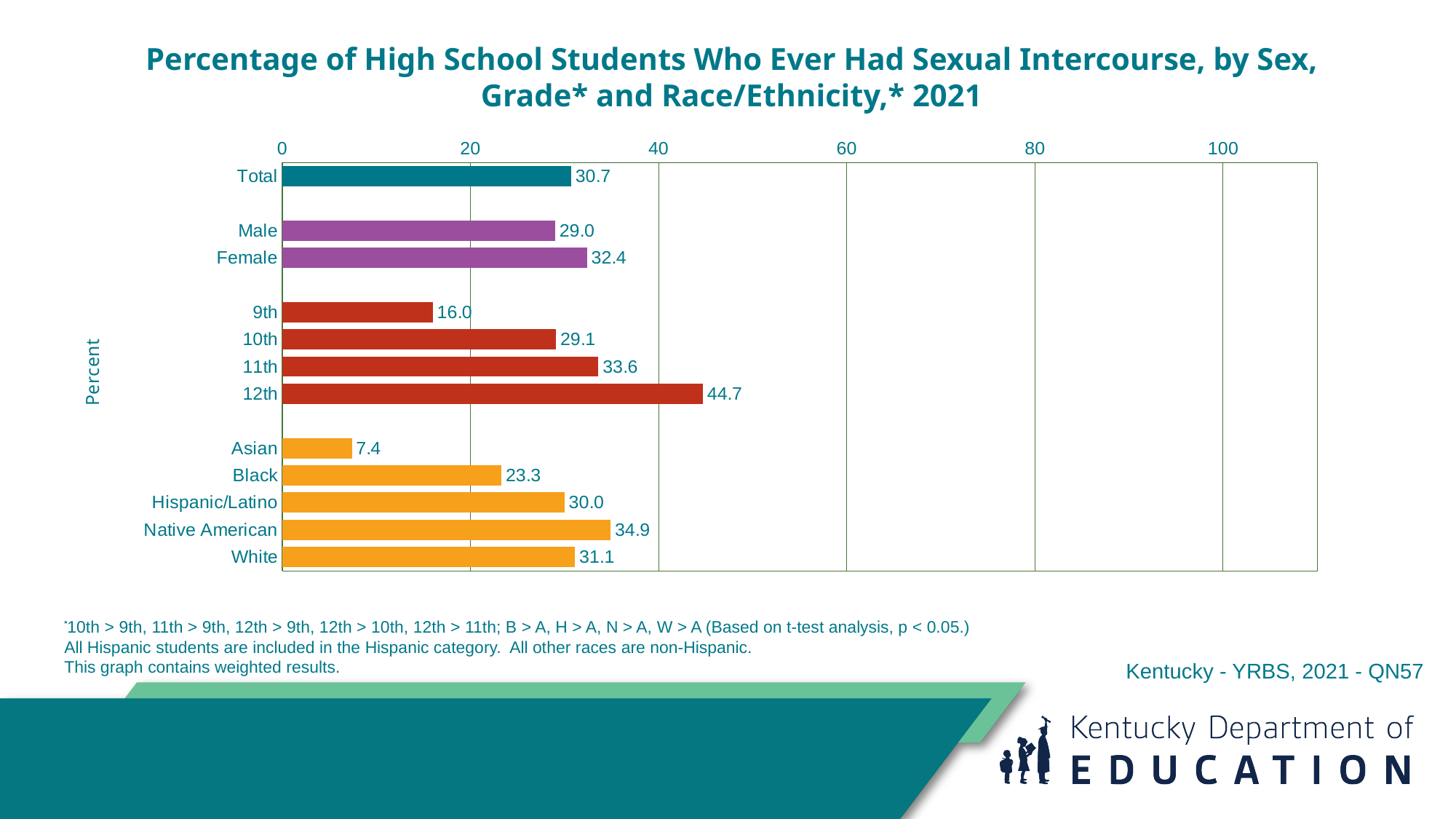
What kind of chart is shown on the slide? bar chart What is the difference between the 12th grade and 9th grade values? 28.7 Is the value for 11th grade greater or less than 40? less Which category has the lowest value on the chart? Asian What is the label on the vertical axis of the chart? Percent What is the value for Native American students? 34.9 Which category has the highest value on the chart? 12th What is the value for 12th grade? 44.7 What is the difference between the Female and Male values? 3.4 Which is larger, the value for Black students or the value for White students? White How many categories are plotted on the chart? 13 What is the value for Total? 30.7